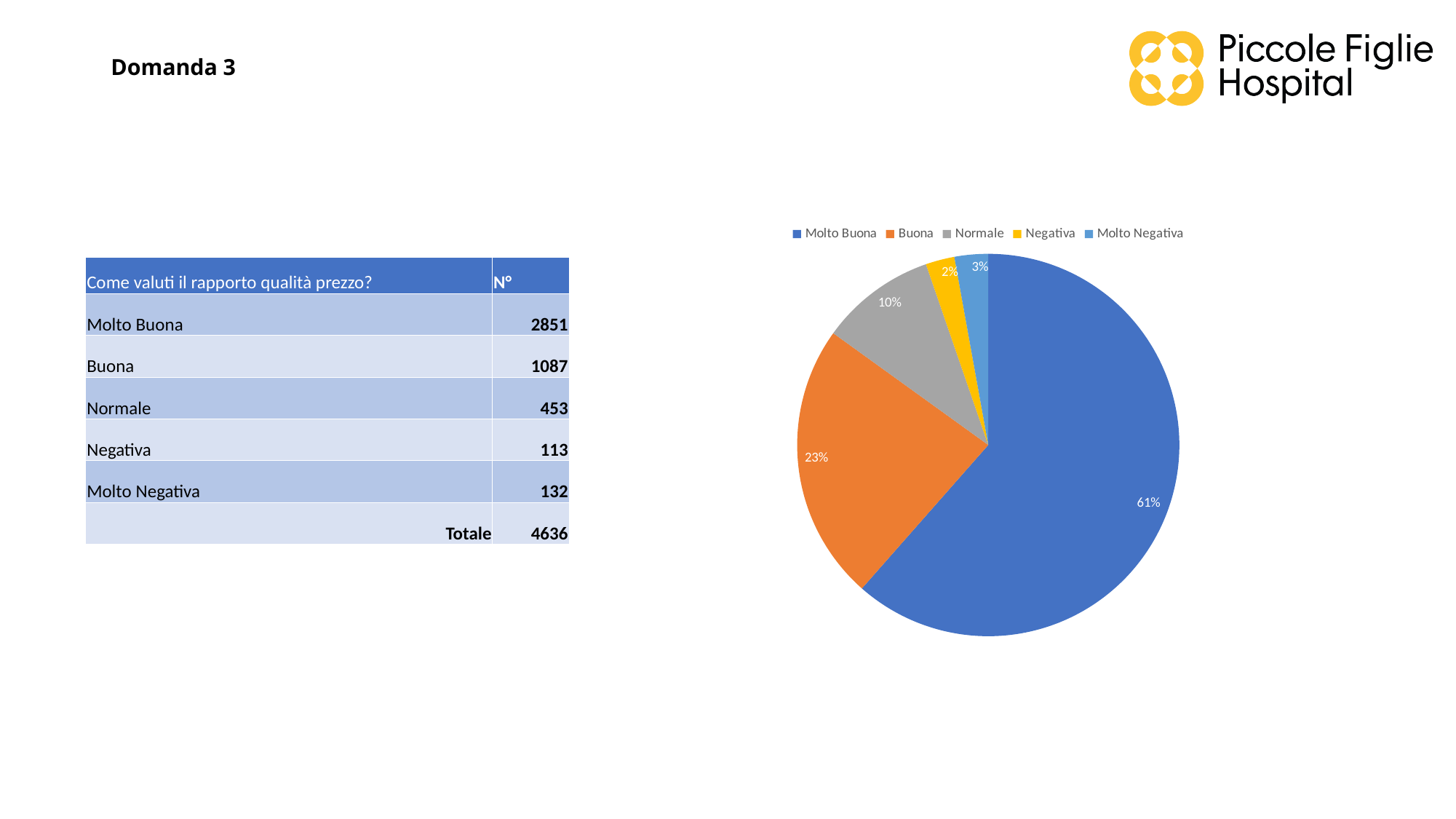
Which category has the largest slice in the pie chart? Molto Buona What percentage of the pie chart does the Molto Buona slice represent? 61% What percentage is shown for the Negativa slice of the pie chart? 2% What percentage is shown for the Normale slice of the pie chart? 10% Which slice is larger in the pie chart, Buona or Normale? Buona What is the difference in percentage points between the Molto Buona and Buona slices of the pie chart? 38 What colour is the Normale slice in the pie chart? grey What kind of chart is shown on the slide? pie chart Which category has the smallest slice in the pie chart? Negativa How many categories does the legend of the pie chart list? 5